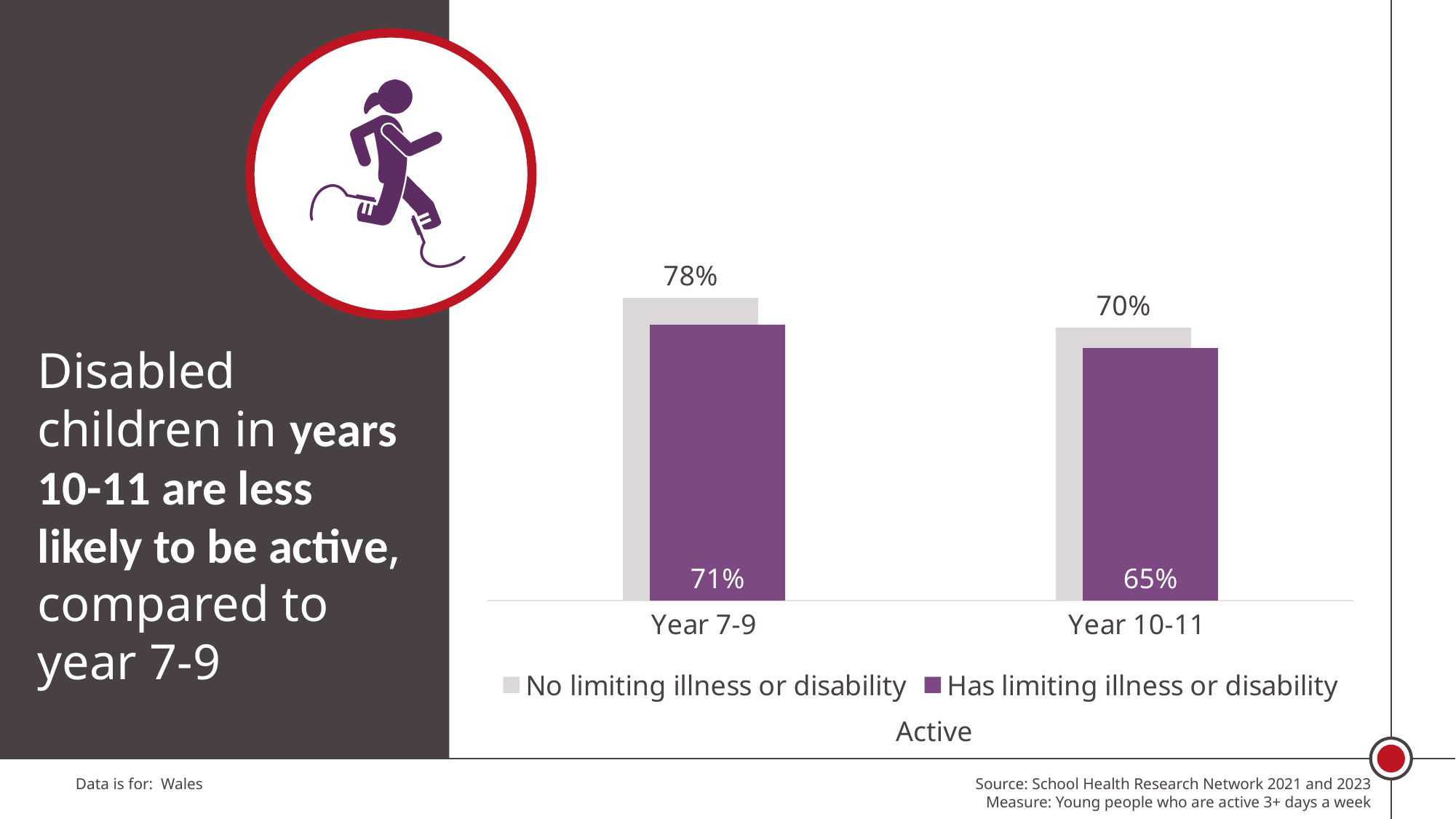
What is the value for 'Has limiting illness or disability' in Year 10-11? 65% Which category has the highest value for 'No limiting illness or disability'? Year 7-9 What kind of chart is shown on the slide? Bar chart How many categories are shown on the x axis? 2 What is the value for 'No limiting illness or disability' in Year 7-9? 78% What is the value for 'No limiting illness or disability' in Year 10-11? 70% What is the value for 'Has limiting illness or disability' in Year 7-9? 71% Which category has the lowest value for 'Has limiting illness or disability'? Year 10-11 What is the difference between the 'Has limiting illness or disability' values for Year 7-9 and Year 10-11? 6% Which is larger in Year 10-11: 'No limiting illness or disability' or 'Has limiting illness or disability'? No limiting illness or disability How many series does the legend list? 2 What is the difference between the 'No limiting illness or disability' and 'Has limiting illness or disability' values in Year 7-9? 7%